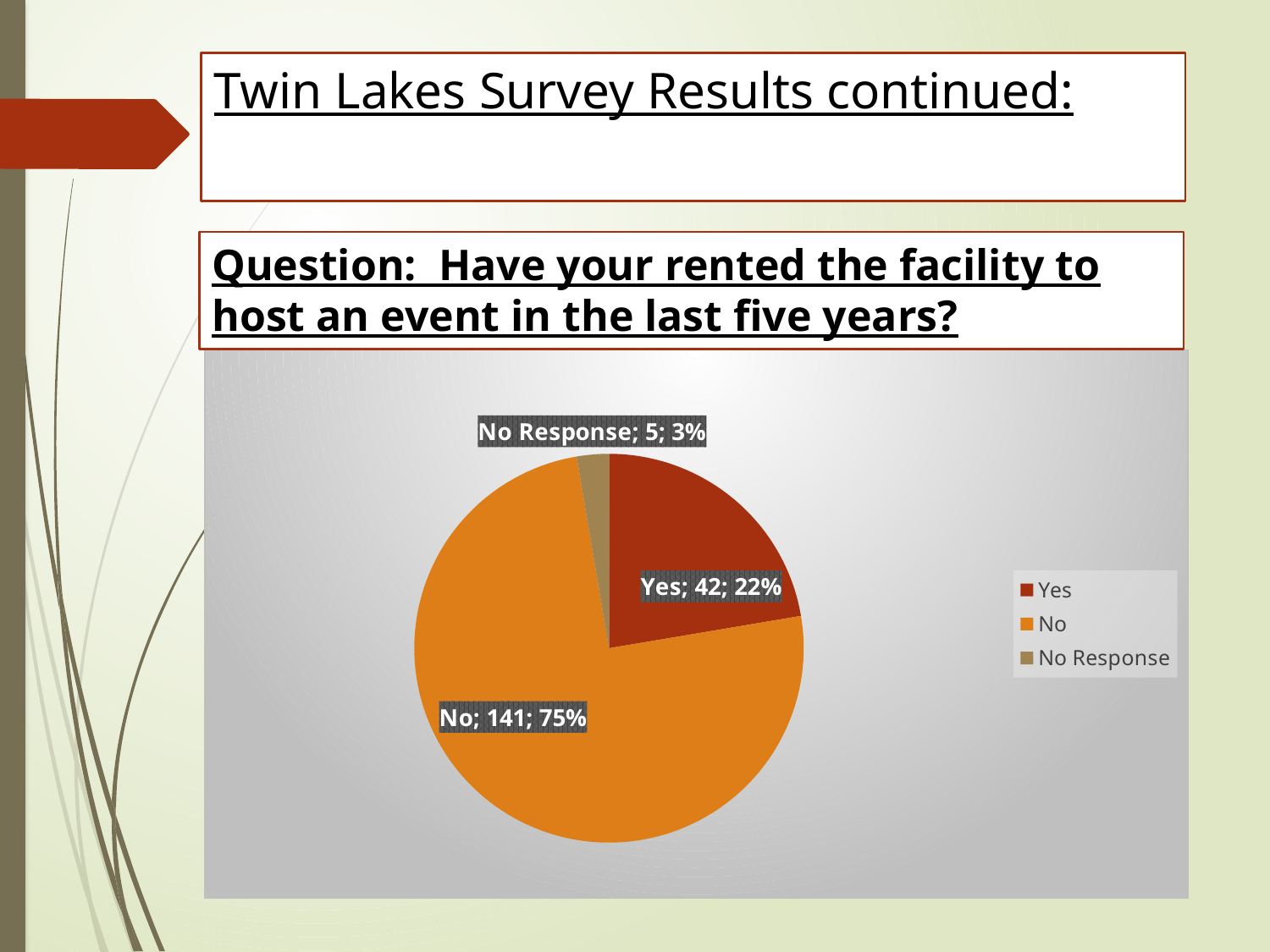
Which category is shown in orange in the legend? No How many respondents answered "Yes"? 42 What percentage of the pie does the "Yes" slice represent? 22% What percentage of the pie does the "No Response" slice represent? 3% What kind of chart is shown on the slide? pie chart How many respondents answered "No"? 141 How many categories does the pie chart have? 3 Which category has the largest slice of the pie? No How many respondents gave "No Response"? 5 Which category has the smallest slice of the pie? No Response What is the difference between the number of "No" and "Yes" responses? 99 What percentage of the pie does the "No" slice represent? 75%